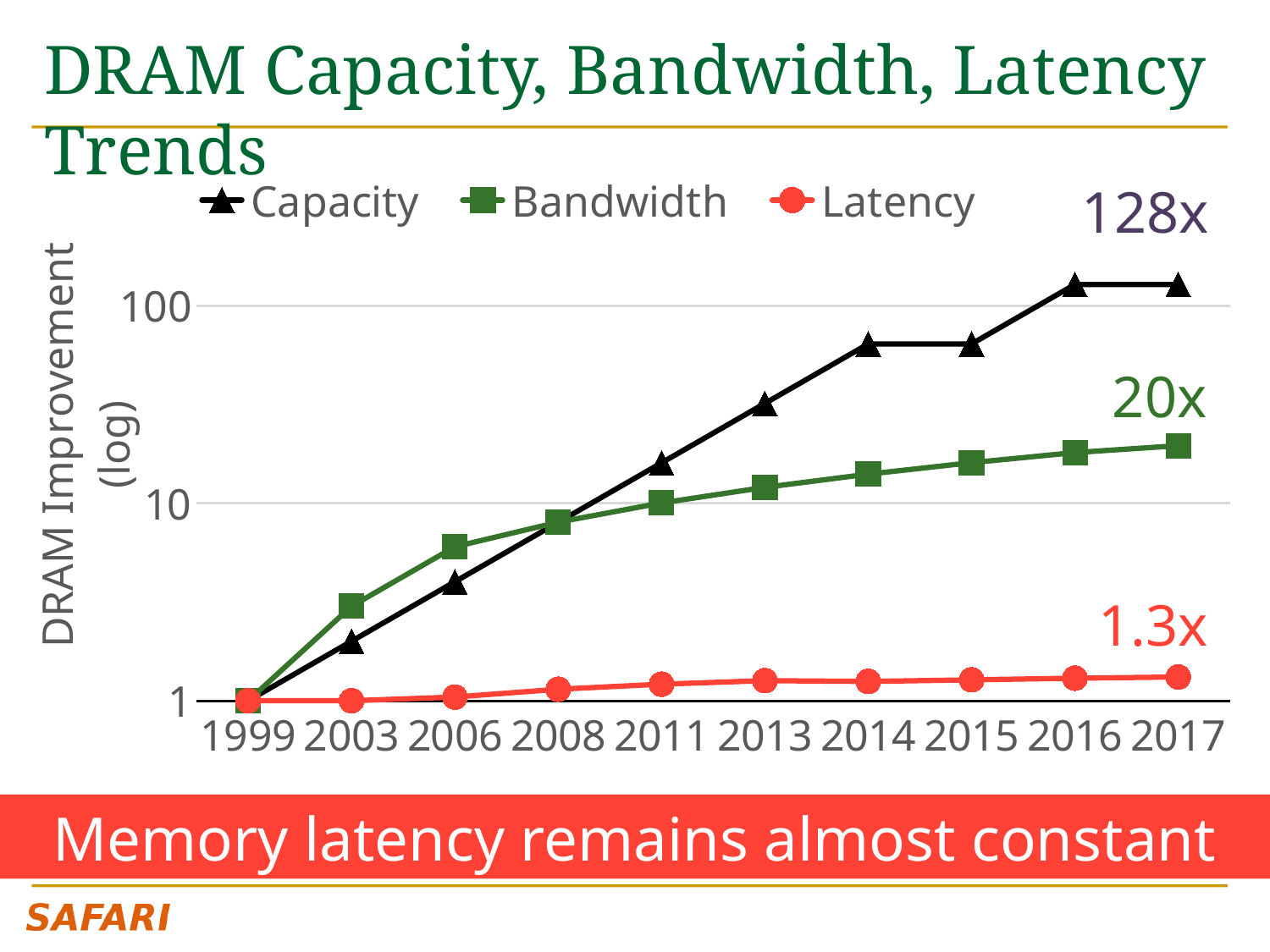
Is the value for Bandwidth in 2003 greater or less than 10? less Which series shows the lowest improvement in 2017? Latency What kind of chart is shown on the slide? line chart What is the DRAM improvement for Latency in 2017? 1.3x How many series does the legend list? 3 What is the DRAM improvement for Capacity in 2017? 128x Does the Capacity series rise or fall from 1999 to 2017? rise What is the difference between the Capacity and Bandwidth improvements in 2017? 108x How many years are marked on the x axis? 10 Which series shows the highest improvement in 2017? Capacity What is the DRAM improvement for Bandwidth in 2017? 20x Is the value for Capacity in 2013 greater or less than 10? greater